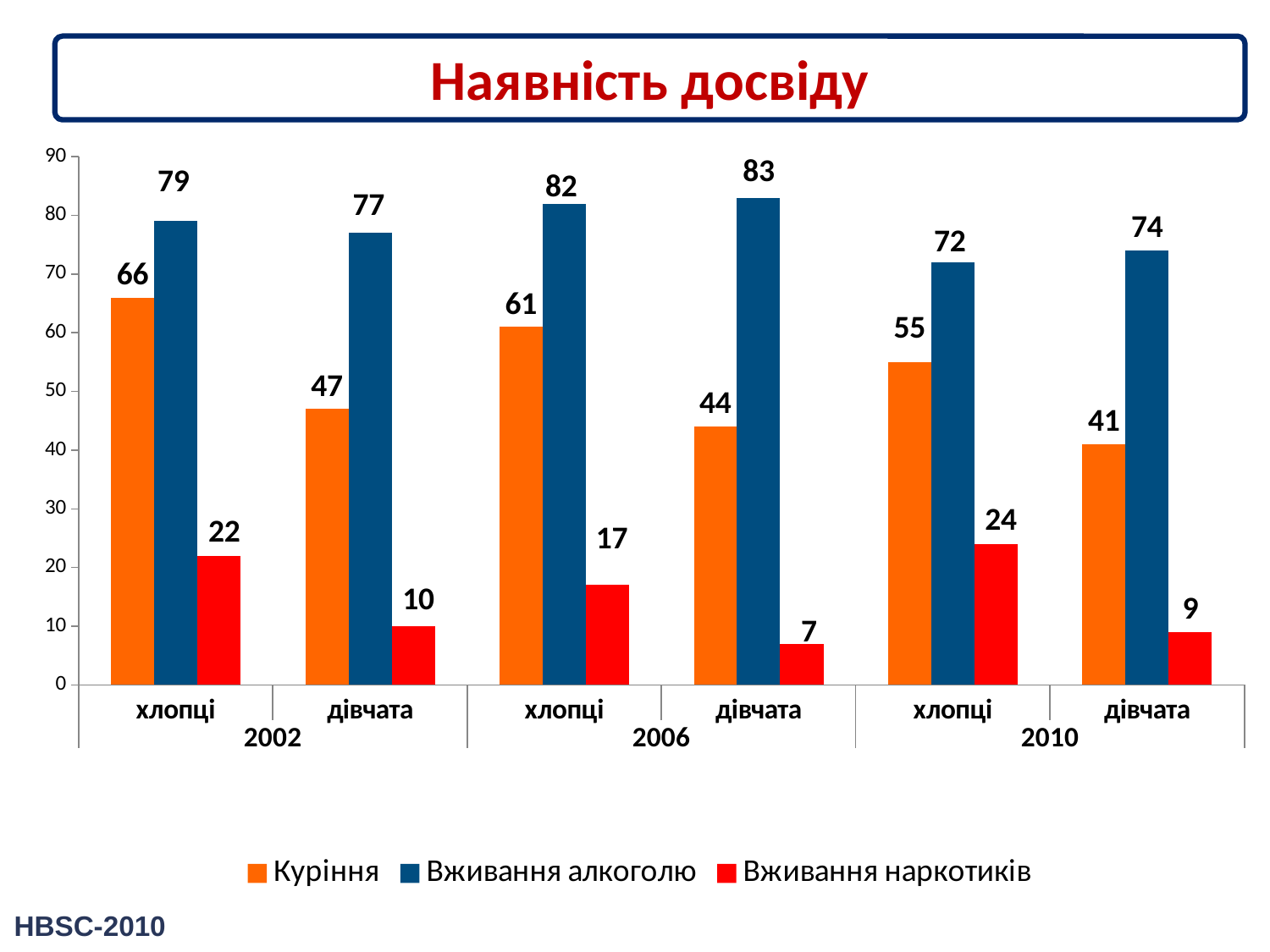
Which group and year has the lowest value for Вживання наркотиків? дівчата, 2006 What is the value for Куріння for хлопці in 2002? 66 What is the value for Вживання алкоголю for дівчата in 2006? 83 Which is larger: Вживання наркотиків for хлопці in 2002 or for хлопці in 2006? хлопці in 2002 Which colour represents Вживання алкоголю in the legend? dark blue What is the difference between the Куріння values for хлопці and дівчата in 2010? 14 What is the title of the chart? Наявність досвіду What is the value for Вживання наркотиків for хлопці in 2010? 24 Which group and year has the highest value for Вживання алкоголю? дівчата, 2006 How many series does the legend list? 3 How does the Куріння value for хлопці change from 2002 to 2010? falls What kind of chart is shown on the slide? bar chart